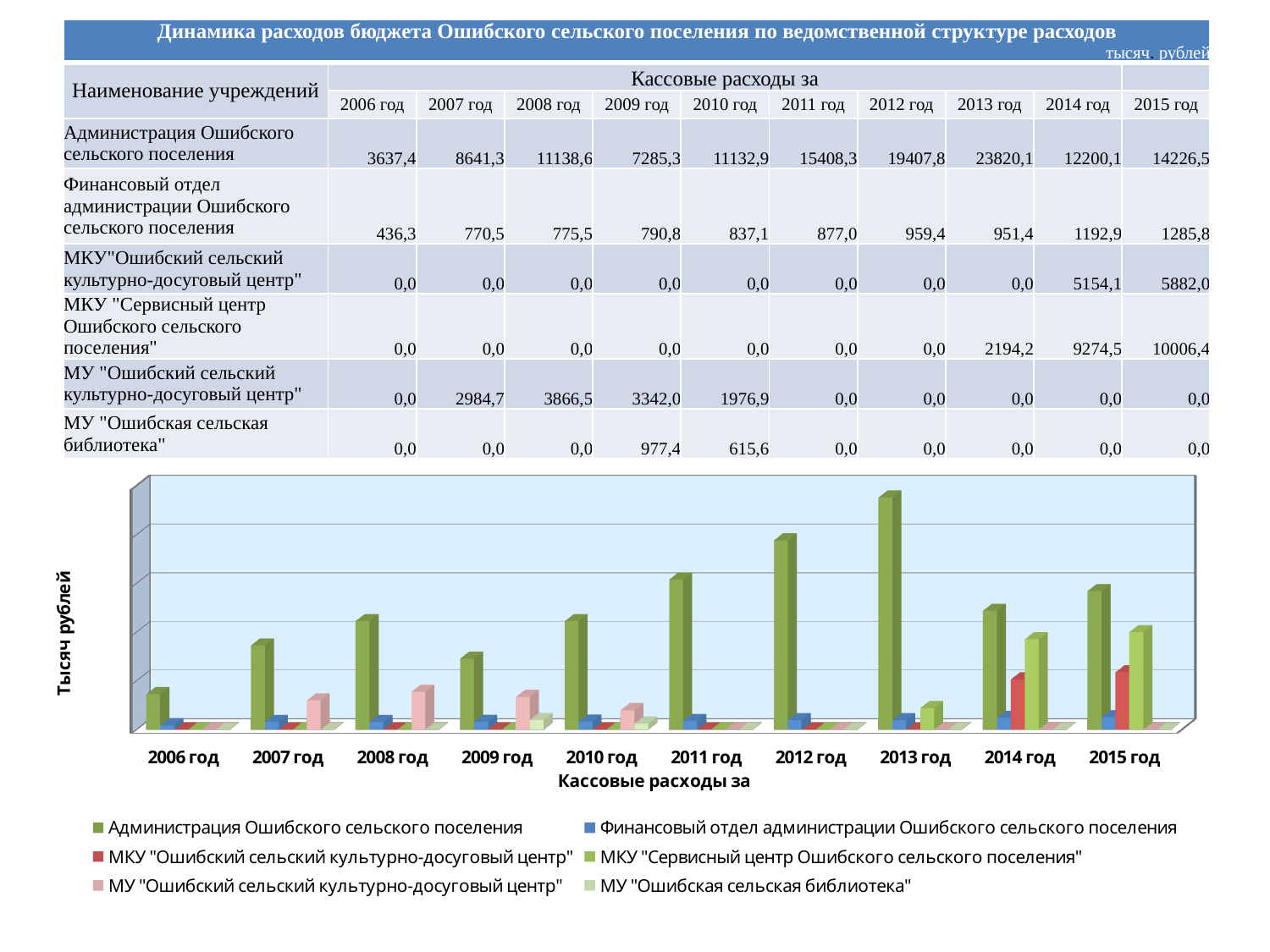
In which year is the bar for Администрация Ошибского сельского поселения the shortest? 2006 год Do the values for Финансовый отдел администрации Ошибского сельского поселения generally rise or fall from 2006 год to 2015 год? rise In which year is the bar for Администрация Ошибского сельского поселения the tallest? 2013 год What kind of chart is shown on the slide? bar chart How many years are shown along the x axis of the chart? 10 How many series does the chart legend list? 6 What is the title of the chart's vertical axis? Тысяч рублей What is the value for Финансовый отдел администрации Ошибского сельского поселения in 2015 год? 1285,8 In 2014 год, which is larger: МКУ "Сервисный центр Ошибского сельского поселения" or МКУ "Ошибский сельский культурно-досуговый центр"? МКУ "Сервисный центр Ошибского сельского поселения" What is the value for Администрация Ошибского сельского поселения in 2013 год? 23820,1 What is the value for МУ "Ошибская сельская библиотека" in 2009 год? 977,4 What is the difference between the values for Администрация Ошибского сельского поселения in 2013 год and 2012 год? 4412,3